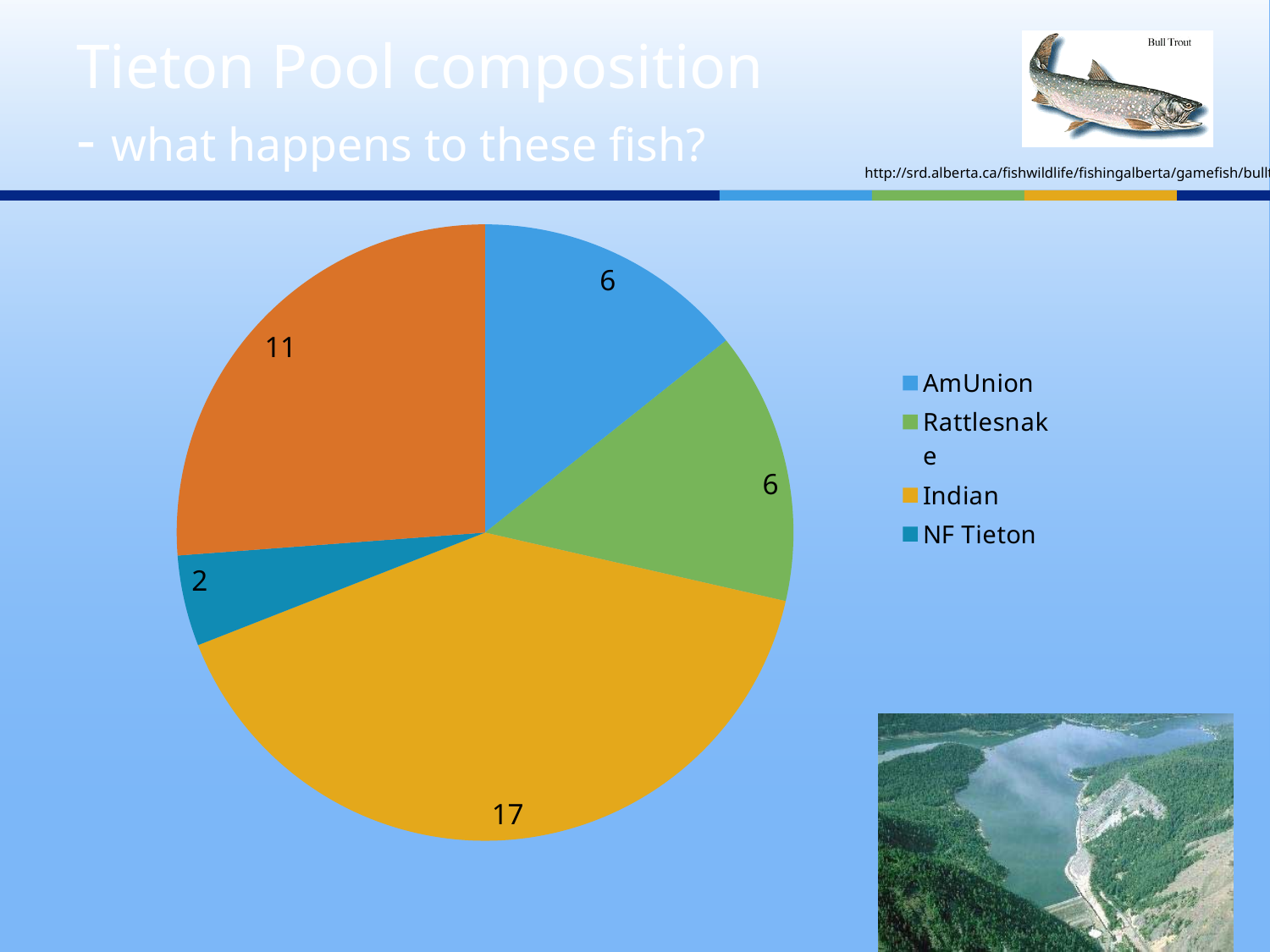
How many slices does the pie chart have? 5 What is the value of the NF Tieton slice in the pie chart? 2 What is the difference between the Indian value and the NF Tieton value? 15 How many entries does the legend list? 4 What is the difference between the Indian value and the AmUnion value? 11 What kind of chart is shown on the slide? Pie chart What is the value of the Rattlesnake slice in the pie chart? 6 Which is larger, the Indian slice or the Rattlesnake slice? Indian What is the value of the AmUnion slice in the pie chart? 6 Which legend category has the smallest slice in the pie chart? NF Tieton What is the value of the Indian slice in the pie chart? 17 Which legend category has the largest slice in the pie chart? Indian